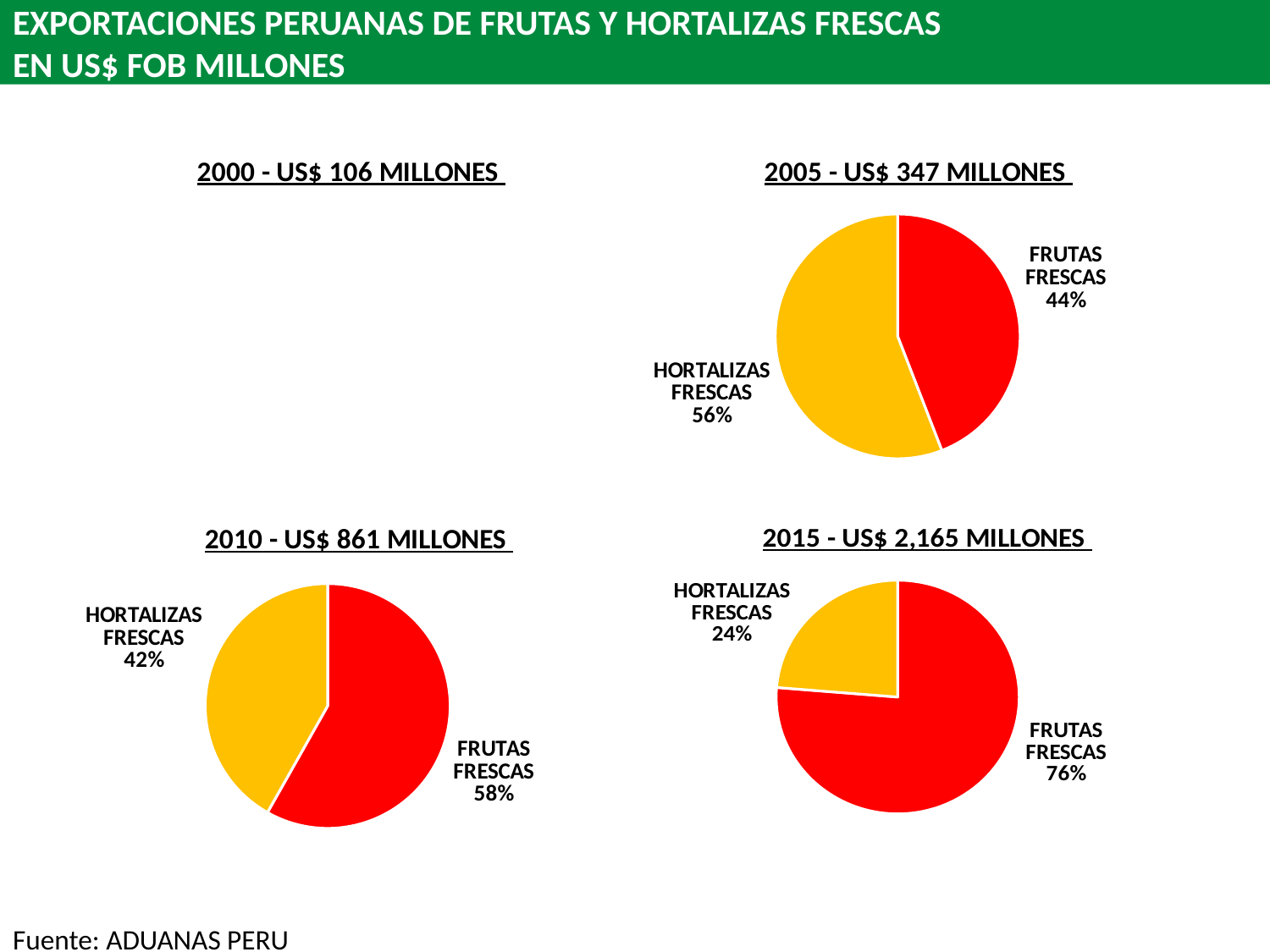
In the 2015 - US$ 2,165 MILLONES chart, what is the difference in percentage points between FRUTAS FRESCAS and HORTALIZAS FRESCAS? 52 In the 2010 - US$ 861 MILLONES chart, what share does FRUTAS FRESCAS have? 58% How many slices does the 2005 - US$ 347 MILLONES chart have? 2 In the 2015 - US$ 2,165 MILLONES chart, which category has the smallest slice? HORTALIZAS FRESCAS In the 2010 - US$ 861 MILLONES chart, what share does HORTALIZAS FRESCAS have? 42% What kind of chart is the 2010 - US$ 861 MILLONES chart? Pie chart In the 2005 - US$ 347 MILLONES chart, what share does FRUTAS FRESCAS have? 44% In the 2010 - US$ 861 MILLONES chart, which is larger, FRUTAS FRESCAS or HORTALIZAS FRESCAS? FRUTAS FRESCAS In the 2005 - US$ 347 MILLONES chart, which category has the largest slice? HORTALIZAS FRESCAS